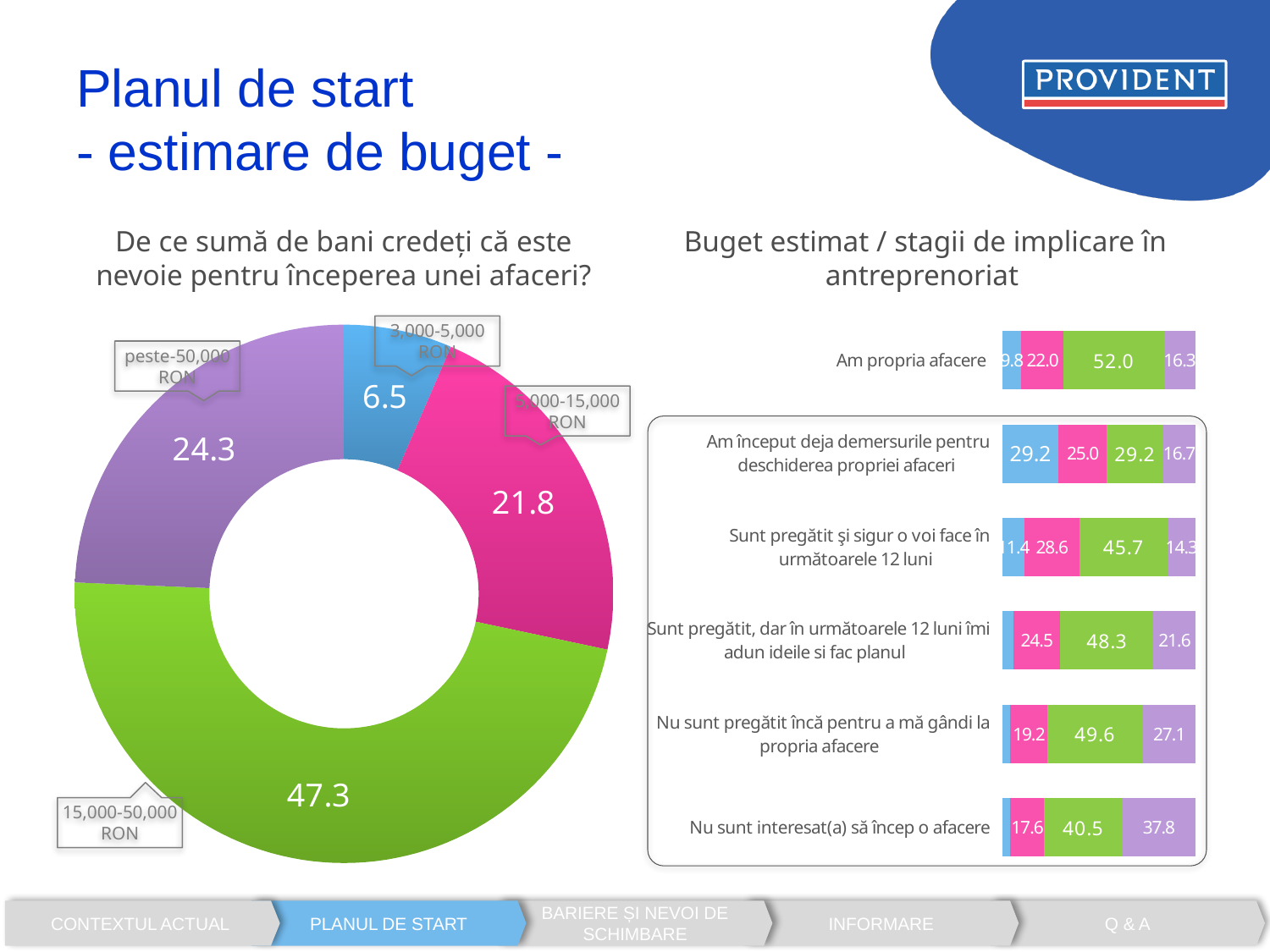
On the donut chart on the left, what percentage of respondents chose 15,000-50,000 RON? 47.3 On the chart titled 'Buget estimat / stagii de implicare în antreprenoriat', what is the value of the purple segment for 'Nu sunt interesat(a) să încep o afacere'? 37.8 On the chart titled 'Buget estimat / stagii de implicare în antreprenoriat', what is the value of the green segment for 'Am propria afacere'? 52.0 On the chart titled 'Buget estimat / stagii de implicare în antreprenoriat', how many categories are listed on the vertical axis? 6 On the donut chart on the left, what is the difference between the 15,000-50,000 RON slice and the peste-50,000 RON slice? 23.0 On the donut chart on the left, which budget range has the largest share? 15,000-50,000 RON On the chart titled 'Buget estimat / stagii de implicare în antreprenoriat', which is larger: the green segment for 'Am propria afacere' or the green segment for 'Am început deja demersurile pentru deschiderea propriei afaceri'? Am propria afacere On the donut chart on the left, what is the value for the 3,000-5,000 RON slice? 6.5 What type of chart is shown on the left side of the slide? Donut chart On the donut chart on the left, which budget range has the smallest share? 3,000-5,000 RON What type of chart is shown on the right side of the slide? Stacked bar chart On the donut chart on the left, how many slices are there? 4